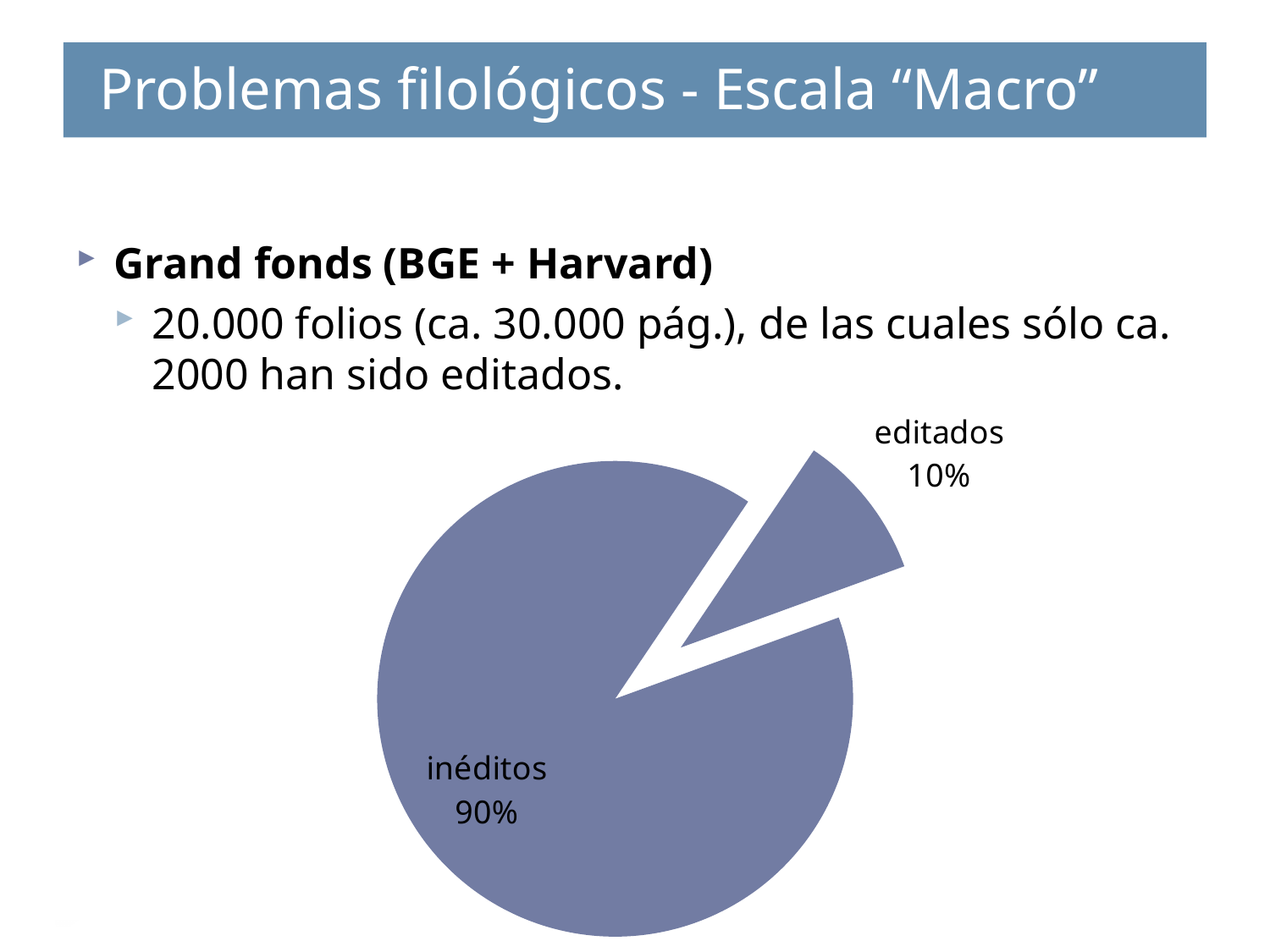
Is the share for "editados" greater or less than 50%? less Which is larger, the "editados" slice or the "inéditos" slice? inéditos What share of the pie does the "editados" slice represent? 10% What is the title of the slide containing the pie chart? Problemas filológicos - Escala "Macro" What share of the pie does the "inéditos" slice represent? 90% What is the difference in percentage points between the "inéditos" and "editados" slices? 80 Which slice is pulled out (exploded) from the pie? editados How many slices does the pie chart have? 2 What kind of chart is shown on the slide? pie chart Which slice of the pie is the largest? inéditos Which slice of the pie is the smallest? editados